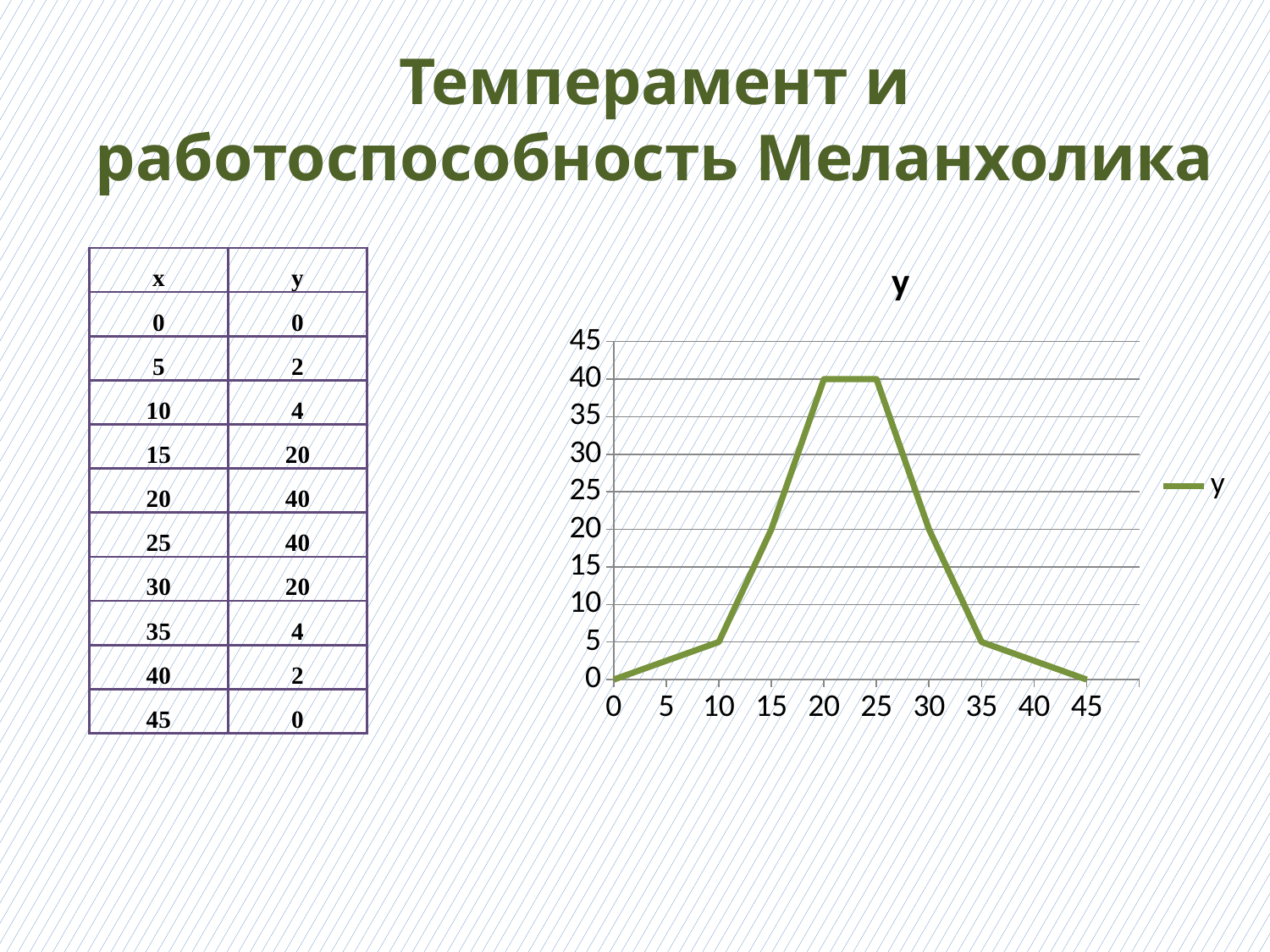
How many series does the legend list? 1 What is the value of y at x = 45? 0 Does the value of y rise or fall as x goes from 25 to 45? fall How many data points are plotted on the chart? 10 What is the value of y at x = 20? 40 Is the value of y at x = 35 greater or less than 10? less What is the difference between the y values at x = 20 and x = 15? 20 What kind of chart is shown on the slide? line chart What is the value of y at x = 15? 20 Which has the larger y value: x = 15 or x = 10? x = 15 What is the highest value of y reached on the chart? 40 Is the value of y at x = 10 greater or less than 10? less